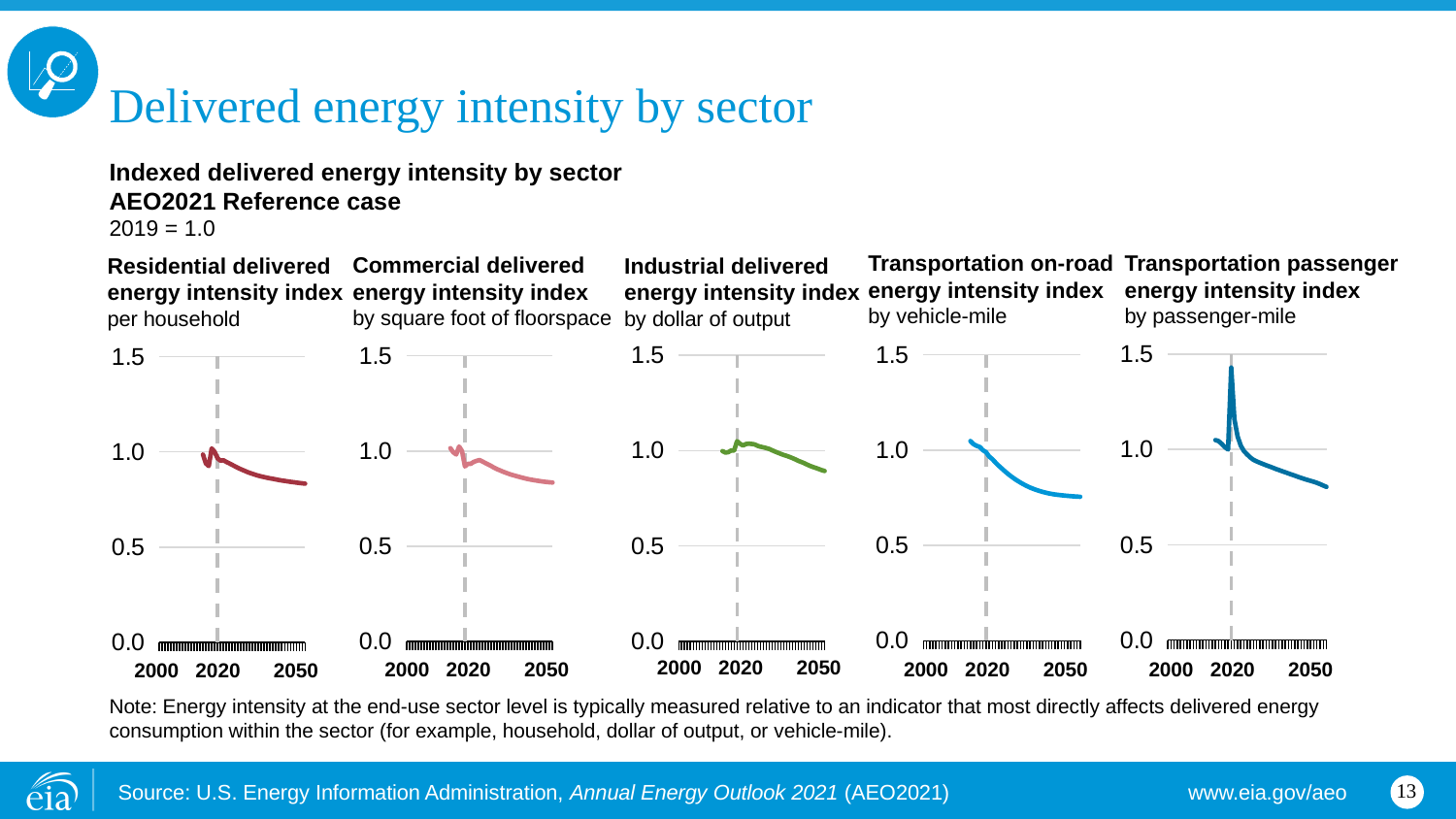
In the Transportation passenger energy intensity index chart, is the peak value around 2020 greater or less than 1.0? greater What kind of chart is used for the Residential delivered energy intensity index? line chart Which of the five charts reaches the highest index value? Transportation passenger energy intensity index How many charts are shown on the slide? 5 What is the highest value shown on the vertical axis of the Commercial delivered energy intensity index chart? 1.5 In the Commercial delivered energy intensity index chart, does the value rise or fall from 2020 to 2050? fall In the Residential delivered energy intensity index chart, is the value in 2050 greater or less than 1.0? less In the Transportation on-road energy intensity index chart, is the value in 2050 greater or less than 1.0? less What is the base year in which the index equals 1.0? 2019 Which is larger in 2050: the Industrial delivered energy intensity index or the Transportation on-road energy intensity index? Industrial delivered energy intensity index In the Transportation on-road energy intensity index chart, does the value rise or fall from 2020 to 2050? fall